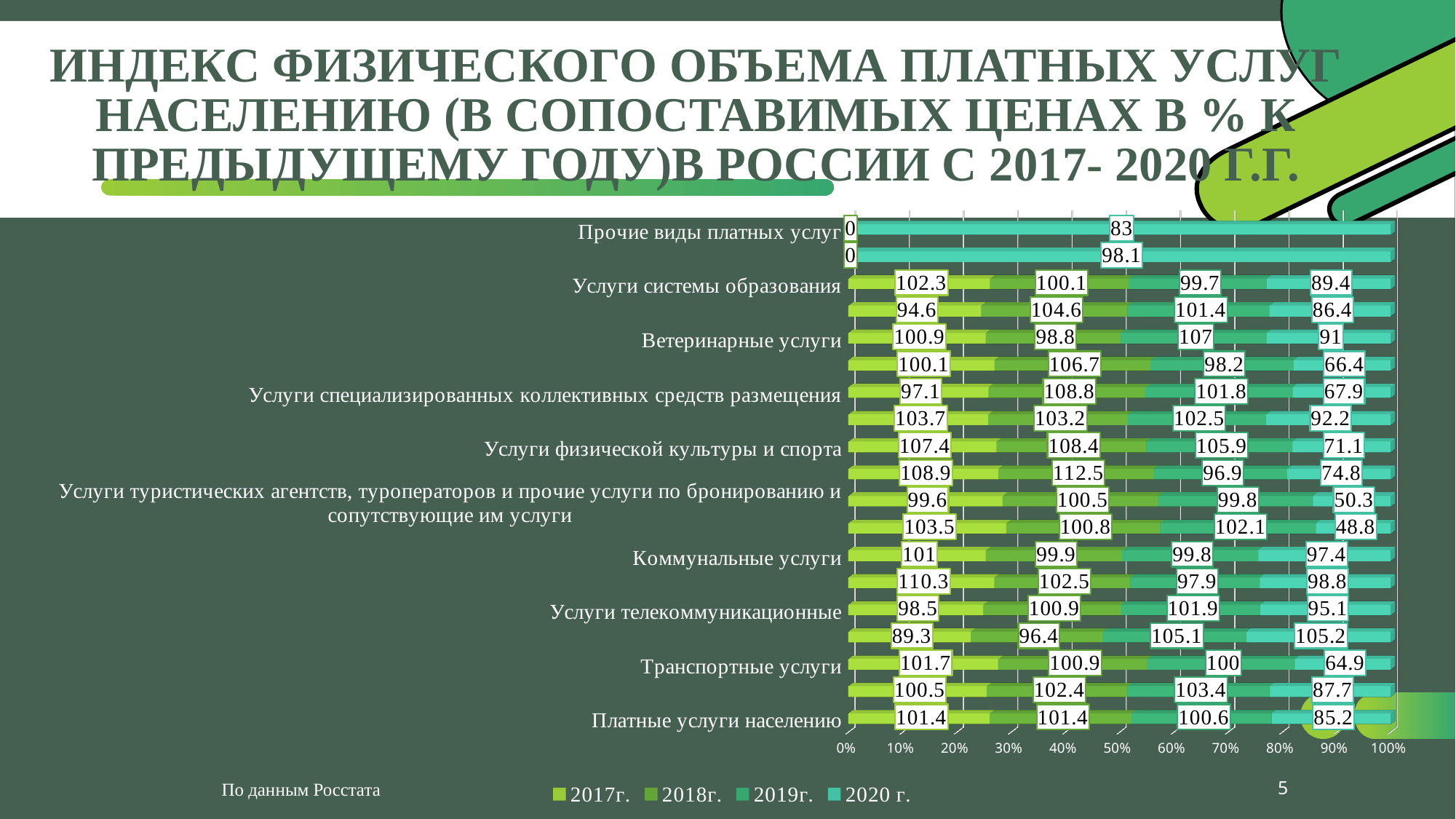
What is the 2019г. value for Ветеринарные услуги? 107 What is the 2019г. value for Услуги телекоммуникационные? 101.9 What is the 2020 г. value for Платные услуги населению? 85.2 What is the 2017г. value for Коммунальные услуги? 101 What kind of chart is shown on the slide? Bar chart What is the 2020 г. value for Транспортные услуги? 64.9 What is the 2018г. value for Услуги физической культуры и спорта? 108.4 What are the entries listed in the chart legend? 2017г., 2018г., 2019г., 2020 г. What is the difference between the 2017г. and 2020 г. values for Услуги системы образования? 12.9 What is the 2020 г. value for Услуги туристических агентств, туроператоров и прочие услуги по бронированию и сопутствующие им услуги? 50.3 Which has the larger 2020 г. value: Транспортные услуги or Коммунальные услуги? Коммунальные услуги How many series does the legend list? 4